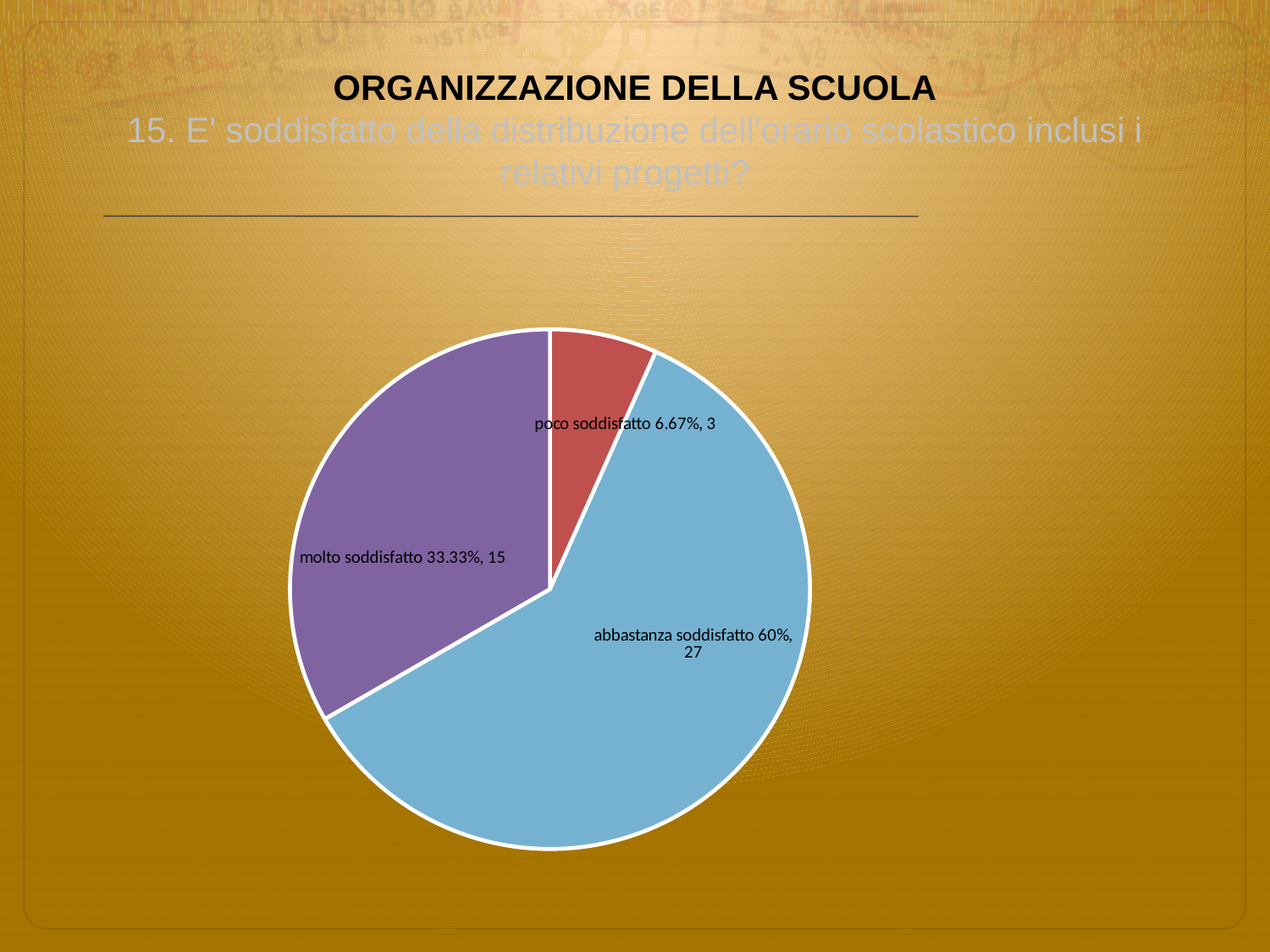
What percentage share does the 'abbastanza soddisfatto' slice have? 60% What percentage share does the 'poco soddisfatto' slice have? 6.67% What percentage share does the 'molto soddisfatto' slice have? 33.33% How many slices does the pie chart have? 3 Which category has the smallest slice of the pie? poco soddisfatto How many respondents answered 'poco soddisfatto'? 3 How many respondents answered 'molto soddisfatto'? 15 What is the difference in respondent count between 'abbastanza soddisfatto' and 'molto soddisfatto'? 12 Which has more respondents, 'molto soddisfatto' or 'poco soddisfatto'? molto soddisfatto What kind of chart is shown on the slide? pie chart Which category has the largest slice of the pie? abbastanza soddisfatto How many respondents answered 'abbastanza soddisfatto'? 27